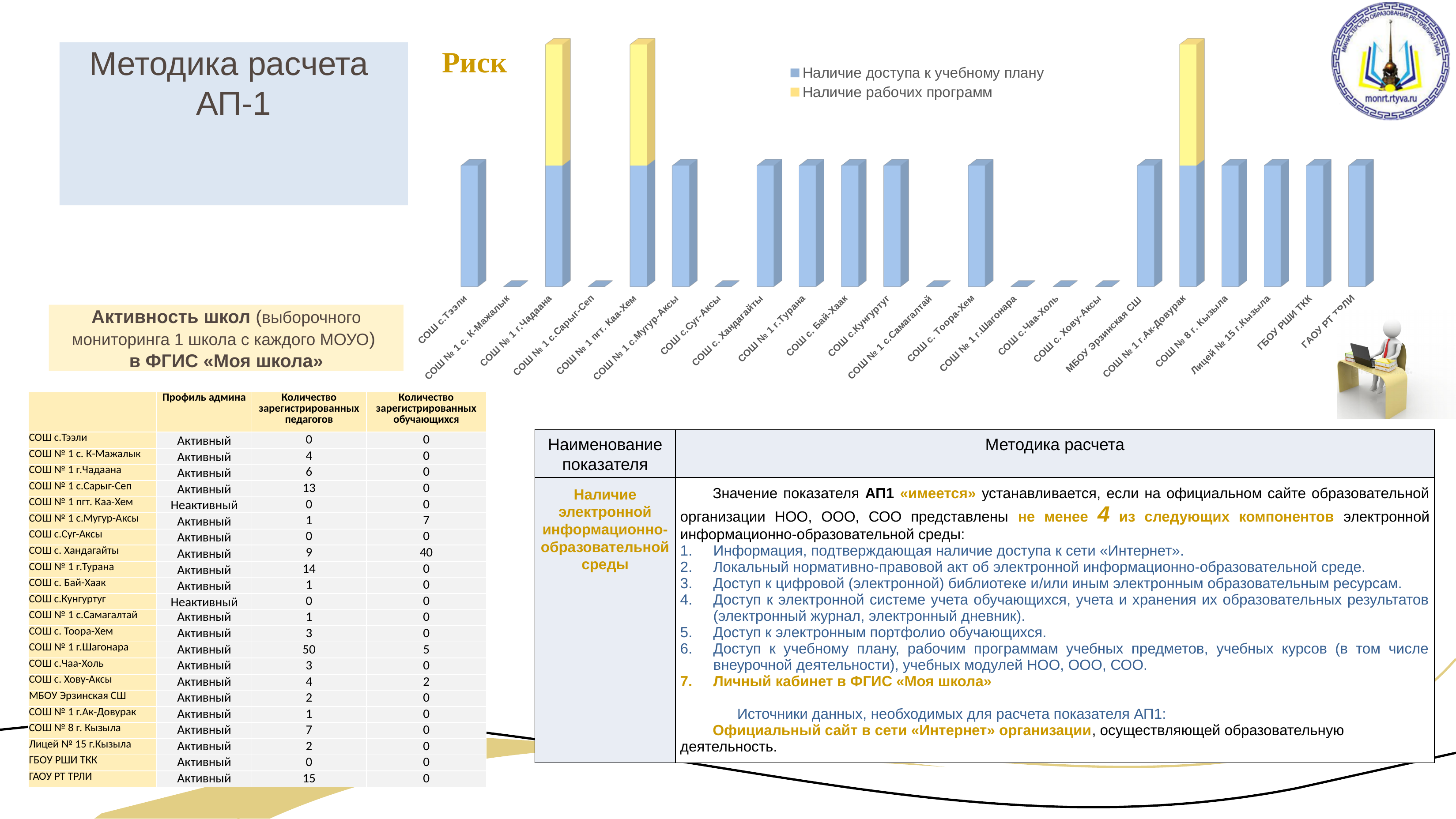
In the bar chart, which has the taller stacked bar: СОШ № 1 пгт. Каа-Хем or СОШ № 1 с.Мугур-Аксы? СОШ № 1 пгт. Каа-Хем What kind of chart is shown at the top of the slide? bar chart In the bar chart, which has the taller stacked bar: СОШ № 1 г.Ак-Довурак or СОШ № 8 г. Кызыла? СОШ № 1 г.Ак-Довурак How many series does the legend of the bar chart list? 2 In the bar chart, which has the taller bar: СОШ с. Хандагайты or СОШ с.Суг-Аксы? СОШ с. Хандагайты What are the two legend entries of the bar chart? Наличие доступа к учебному плану; Наличие рабочих программ How many schools in the bar chart have a yellow segment for Наличие рабочих программ? 3 What title is written in gold above the bar chart? Риск How many schools (categories) are shown on the x axis of the bar chart? 22